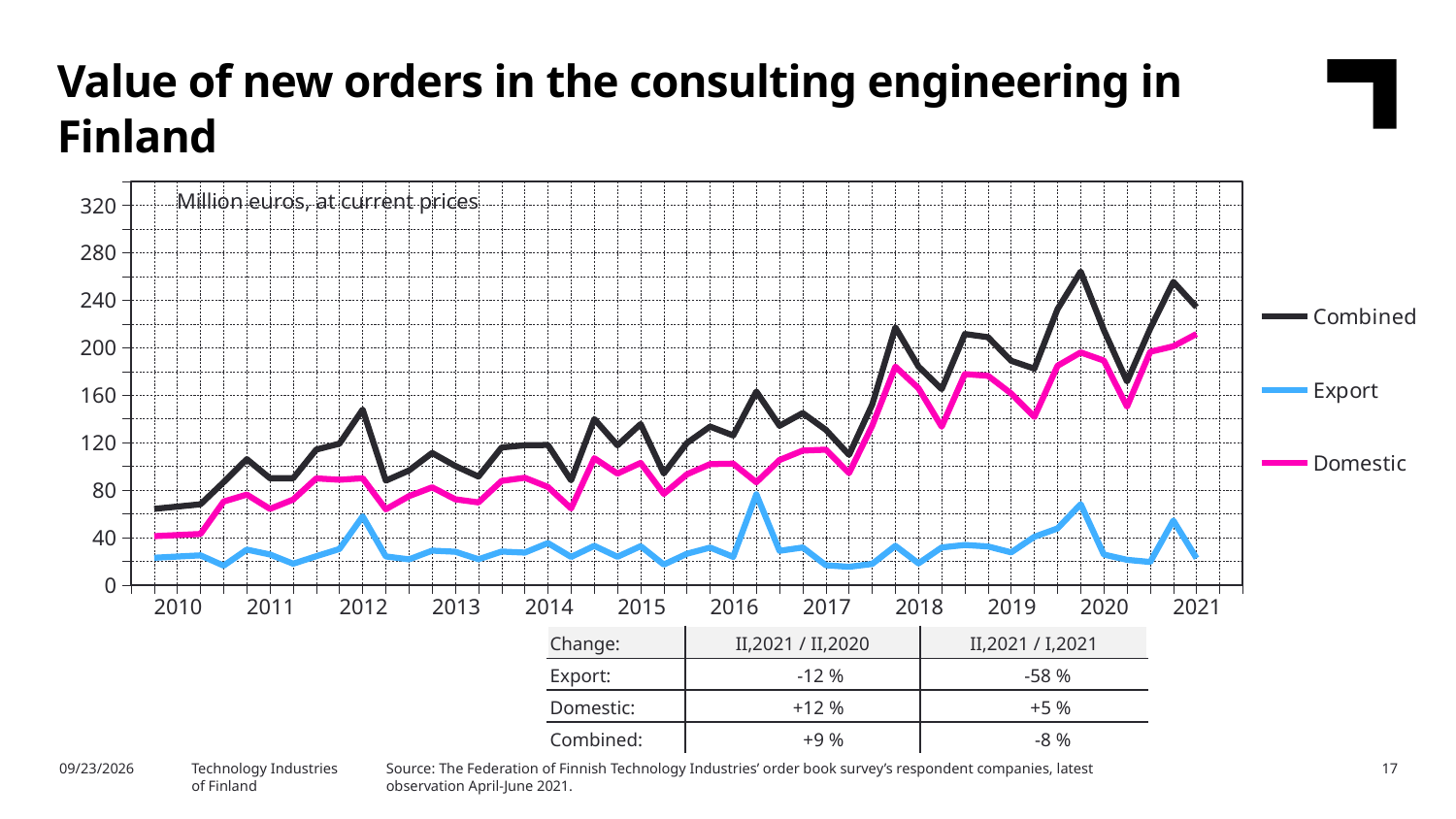
Which series has the lowest values throughout the chart? Export Is the peak value of the Combined series (around late 2019) greater or less than 240? greater Which series has the highest values throughout the chart? Combined Which series are listed in the legend? Combined, Export, Domestic How many years are labelled on the x axis? 12 At the last observation in 2021, which is larger, Domestic or Export? Domestic How many series does the legend list? 3 What kind of chart is shown on the slide? Line chart What colour is the Export line? Blue Is the value for Domestic at the last observation in 2021 greater or less than 200? greater Does the Combined series generally rise or fall from 2010 to 2021? Rise Is the value for Export at the start of 2010 greater or less than 40? less